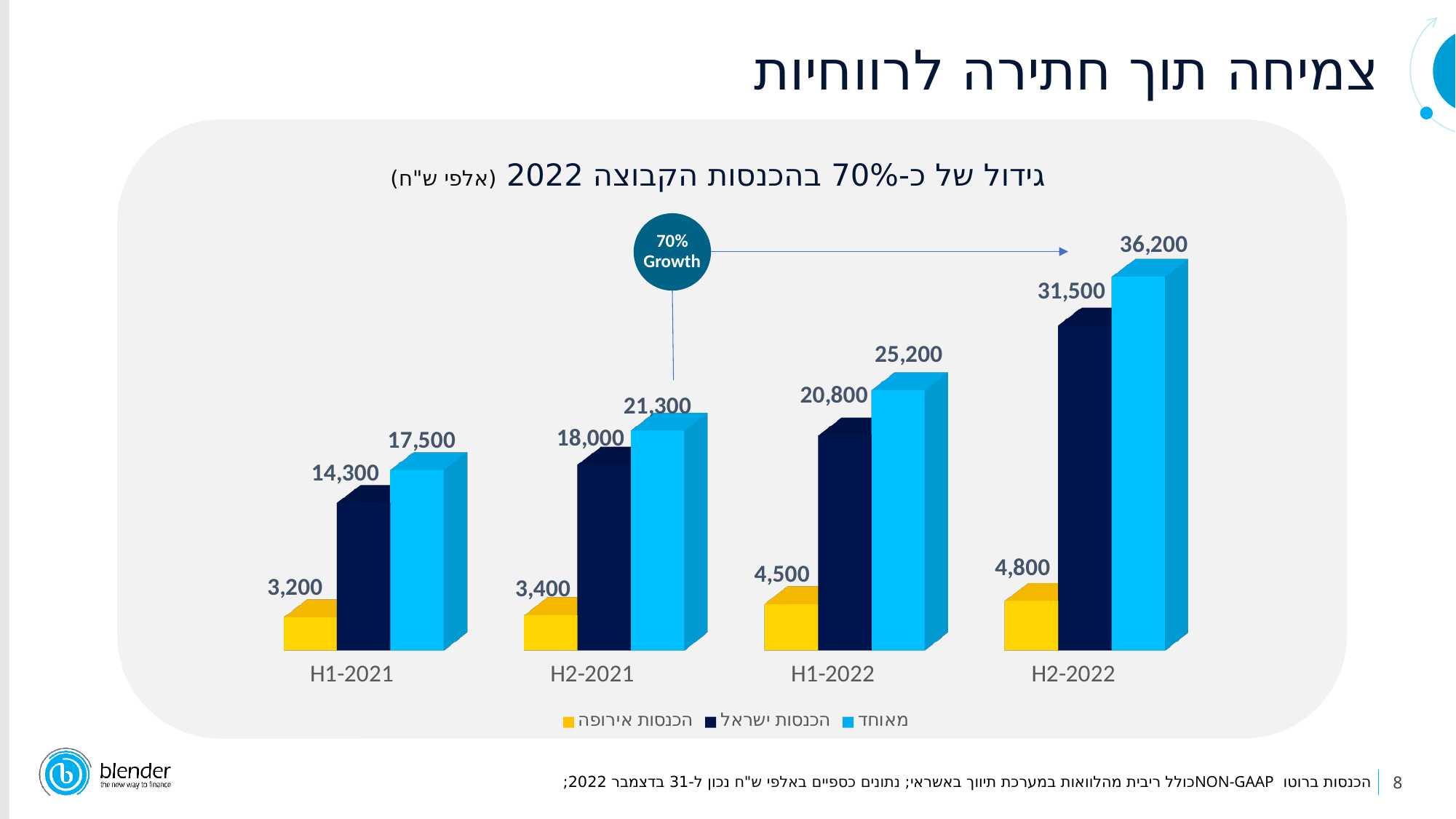
What is the difference between הכנסות ישראל for H2-2021 and H1-2021? 3,700 How many series does the legend list? 3 What is the value of מאוחד for H1-2021? 17,500 Which period has the lowest הכנסות אירופה value? H1-2021 How many periods are shown on the x axis? 4 What is the difference between the מאוחד values for H2-2022 and H1-2022? 11,000 What is the value of הכנסות ישראל for H2-2022? 31,500 What kind of chart is shown on the slide? Bar chart Do the מאוחד values rise or fall from H1-2021 to H2-2022? Rise Which is larger: הכנסות ישראל for H1-2022 or מאוחד for H2-2021? מאוחד for H2-2021 Which period has the highest מאוחד value? H2-2022 What is the value of הכנסות אירופה for H1-2022? 4,500